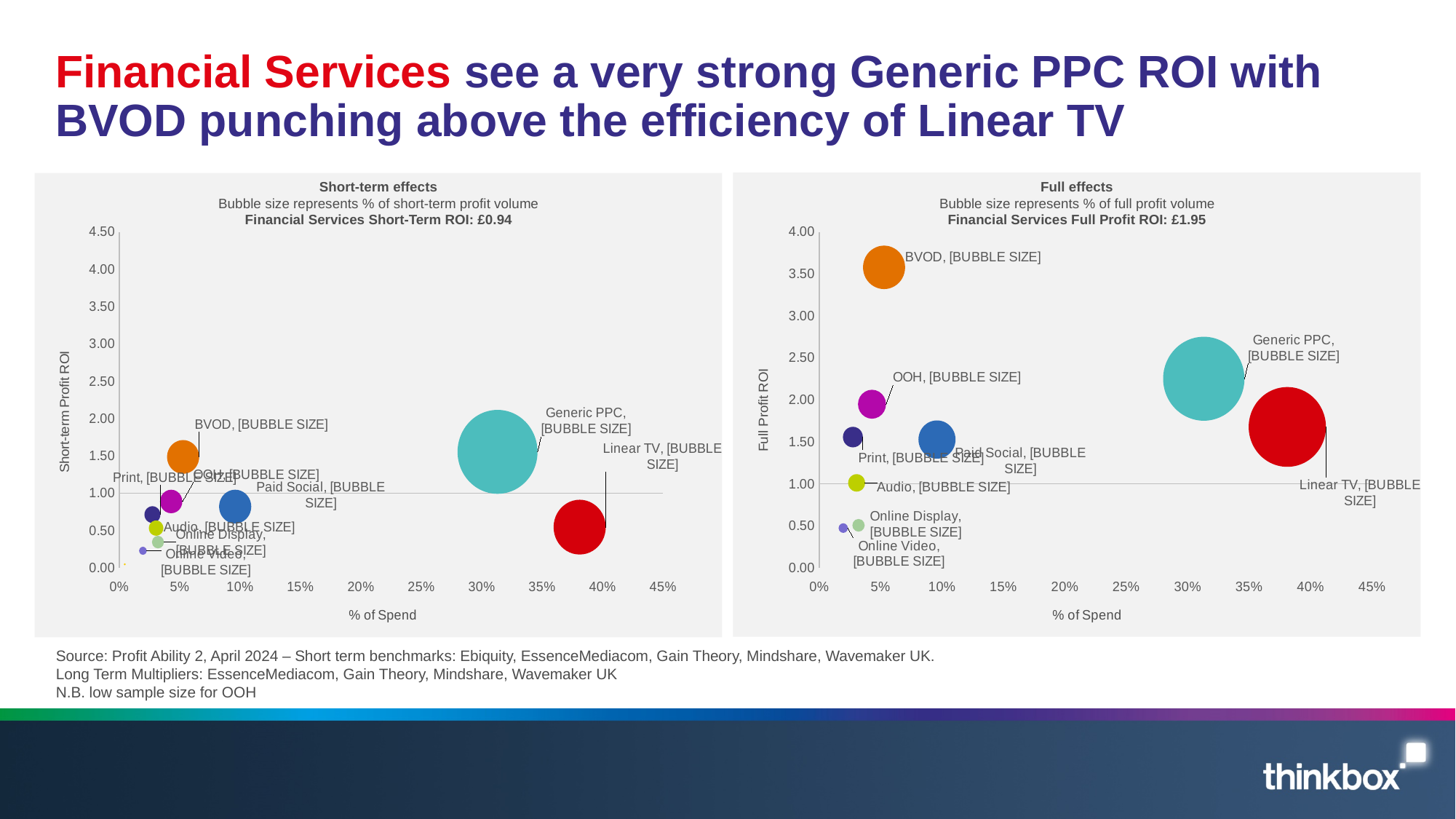
How many channel bubbles are plotted in the Full effects chart? 9 In the Full effects chart, is the full profit ROI for Generic PPC greater or less than 2.00? greater In the Short-term effects chart, which channel has the lowest short-term profit ROI? Online Video What type of chart is the Short-term effects chart? Bubble chart In the Short-term effects chart, which has the higher short-term profit ROI, Generic PPC or Linear TV? Generic PPC In the Full effects chart, is the full profit ROI for BVOD greater or less than 3.00? greater In the Short-term effects chart, is the short-term profit ROI for Linear TV greater or less than 1.00? less In the Full effects chart, which channel has the highest % of spend? Linear TV What Financial Services Full Profit ROI is stated in the title of the Full effects chart? £1.95 In the Full effects chart, which channel has the highest full profit ROI? BVOD In the Short-term effects chart, which channel has the highest short-term profit ROI? Generic PPC What Financial Services Short-Term ROI is stated in the title of the Short-term effects chart? £0.94